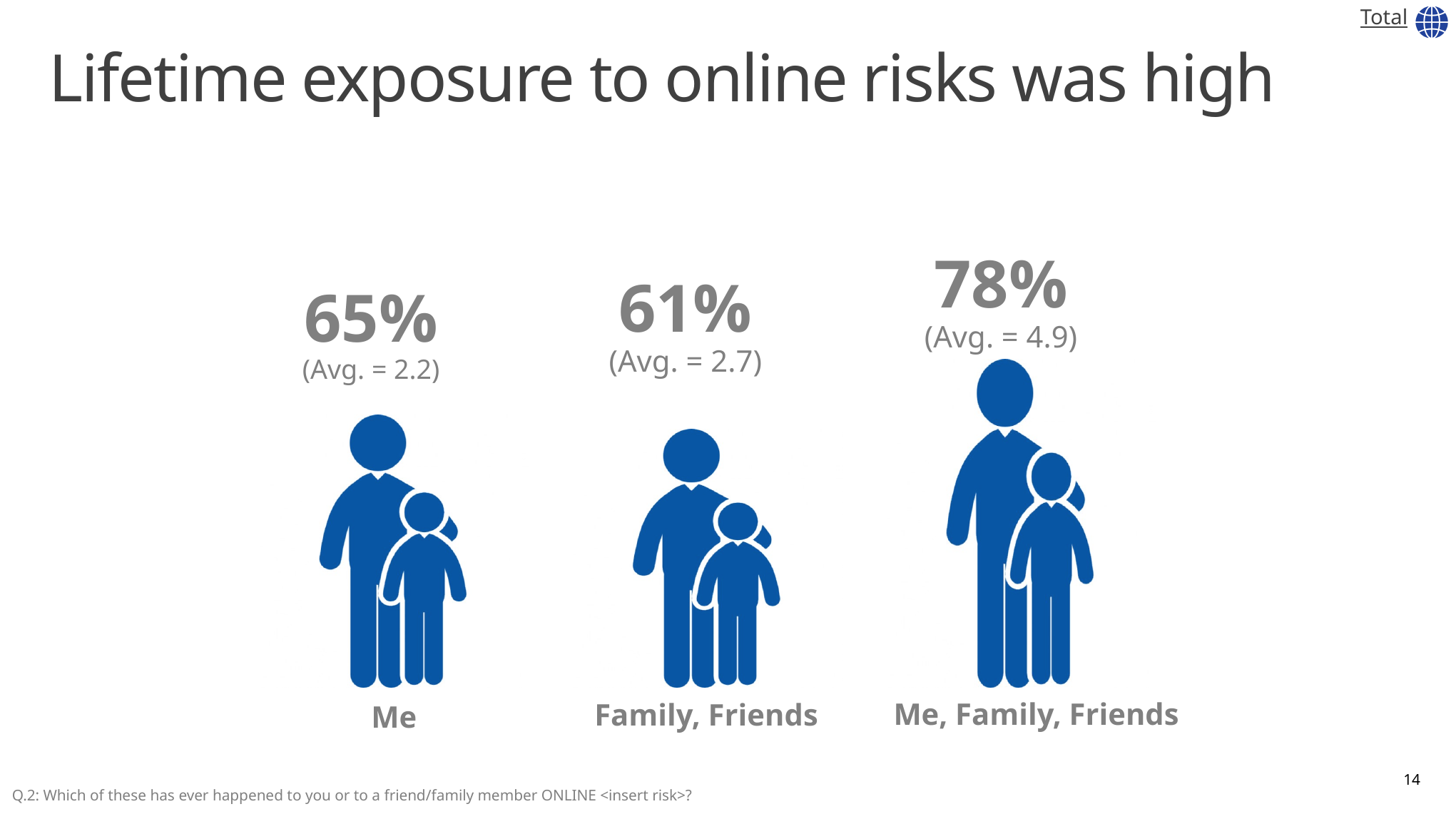
What percentage is shown for the "Me" category? 65% What is the title of the slide containing the chart? Lifetime exposure to online risks was high Which category has the lowest percentage? Family, Friends What is the average value shown for the "Me" category? 2.2 What percentage is shown for the "Family, Friends" category? 61% How many categories are shown in the chart? 3 Which has a higher percentage, "Me" or "Family, Friends"? Me What is the difference in percentage points between "Me, Family, Friends" and "Me"? 13 What percentage is shown for the "Me, Family, Friends" category? 78% What is the average value shown for the "Family, Friends" category? 2.7 What is the average value shown for the "Me, Family, Friends" category? 4.9 Which category has the highest percentage? Me, Family, Friends